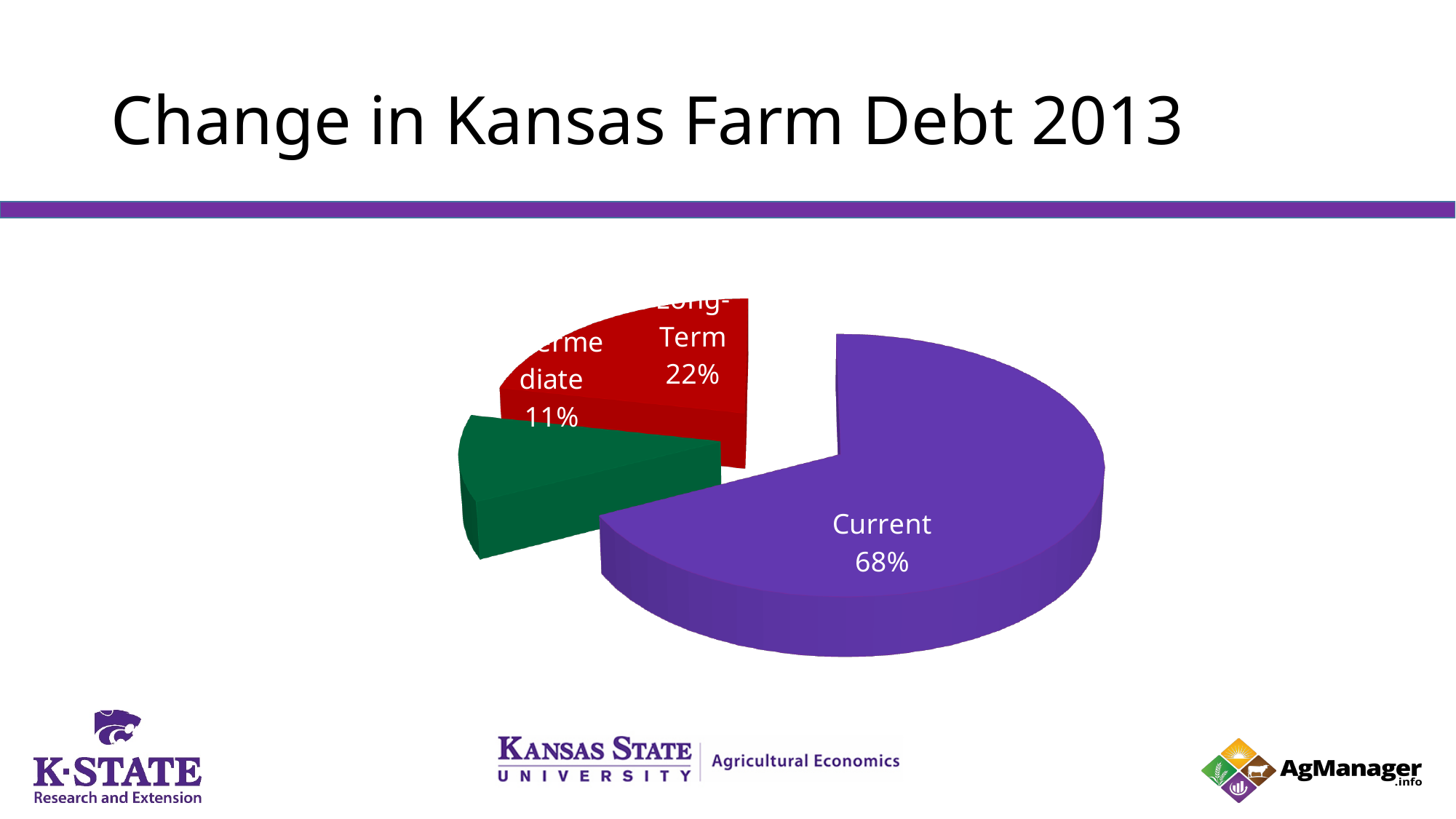
How many slices does the pie chart have? 3 What percentage is shown for the Current slice? 68% What percentage is shown for the Long-Term slice? 22% What colour is the Current slice of the pie chart? purple Which is larger, the Current slice or the Long-Term slice? Current What share of the pie does the Current slice represent? 68% What kind of chart is shown on the slide? pie chart What is the title of the slide containing the pie chart? Change in Kansas Farm Debt 2013 By how many percentage points does the Current slice exceed the Long-Term slice? 46 percentage points Is the value for Current greater or less than 50%? greater Which slice of the pie chart is the largest? Current